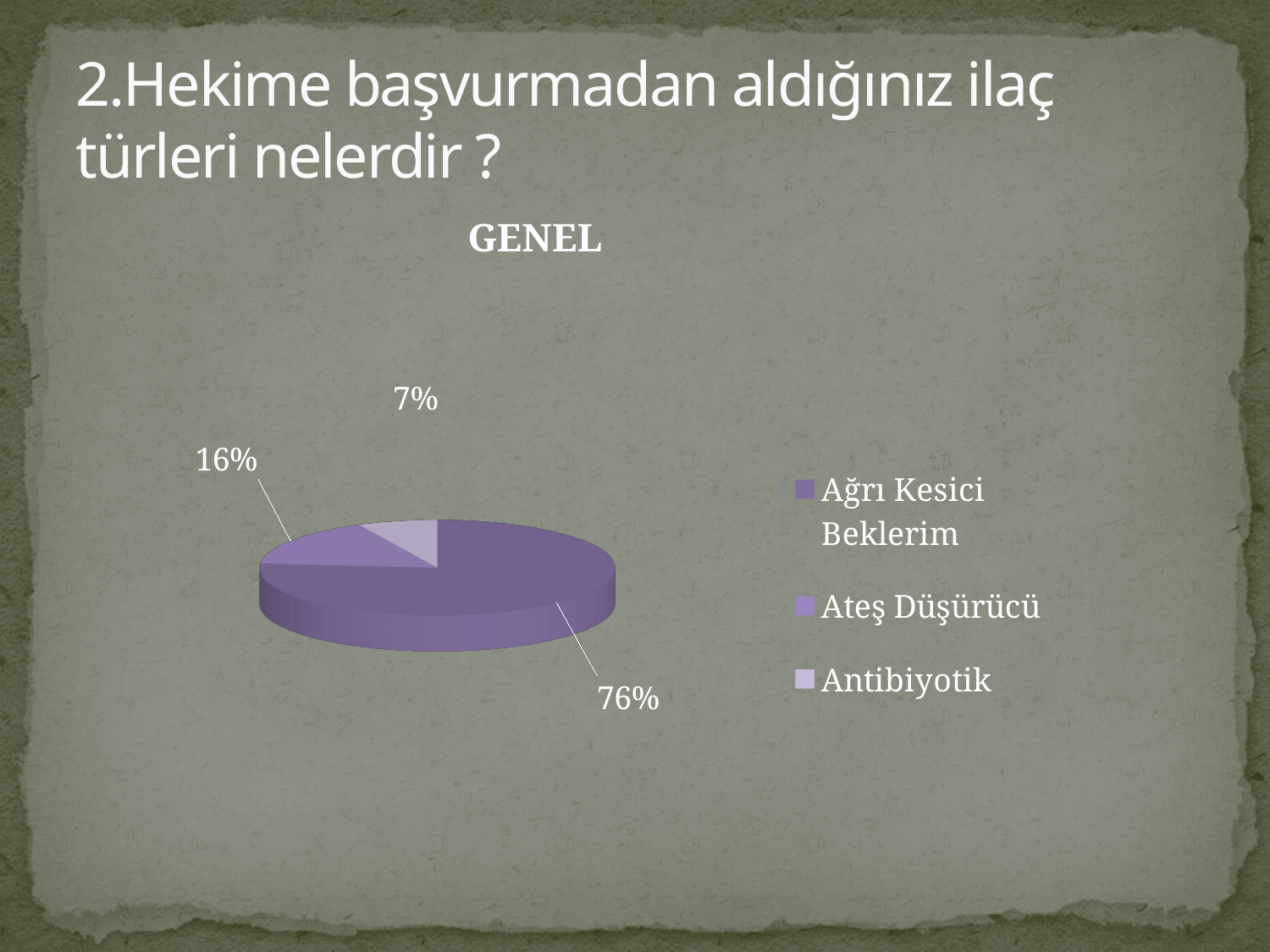
How many slices does the pie chart have? 3 What kind of chart is shown on the slide? pie chart What share of the pie does Antibiyotik have? 7% What share of the pie does Ateş Düşürücü have? 16% Which category has the smallest slice of the pie? Antibiyotik What is the difference in percentage points between Ateş Düşürücü and Antibiyotik? 9 Which category has the largest slice of the pie? Ağrı Kesici Beklerim Which is larger, the share for Ateş Düşürücü or the share for Antibiyotik? Ateş Düşürücü How many entries does the legend list? 3 What is the title of the chart? GENEL What is the difference in percentage points between Ağrı Kesici Beklerim and Ateş Düşürücü? 60 What share of the pie does Ağrı Kesici Beklerim have? 76%